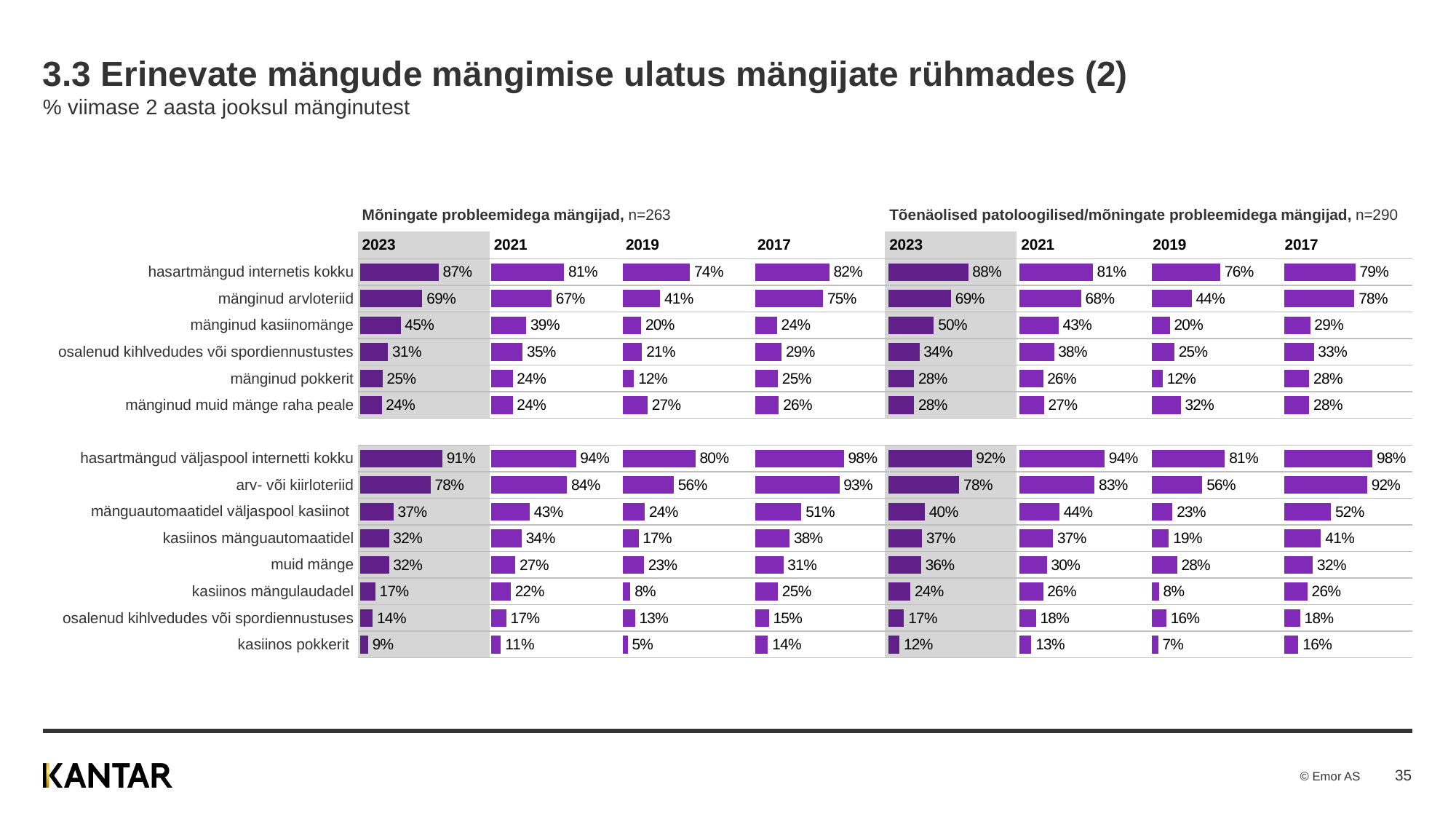
In the right chart (n=290), what is the difference between the 2023 and 2021 values for 'mänginud kasiinomänge'? 7 percentage points What type of chart is used on the slide? Bar chart In the right chart (n=290), which category has the highest 2023 value? hasartmängud väljaspool internetti kokku In the left chart (n=263), what is the difference between the 2017 and 2019 values for 'arv- või kiirloteriid'? 37 percentage points In the left chart (Mõningate probleemidega mängijad, n=263), what is the 2023 value for 'hasartmängud internetis kokku'? 87% In the left chart (n=263), which category has the lowest 2023 value? kasiinos pokkerit In the right chart (n=290), which is larger for 'kasiinos mänguautomaatidel': the 2017 value or the 2019 value? 2017 (41%) In the right chart (Tõenäolised patoloogilised/mõningate probleemidega mängijad, n=290), what is the 2017 value for 'mänginud arvloteriid'? 78% How many categories are listed in the lower block (starting with 'hasartmängud väljaspool internetti kokku')? 8 How many year columns are shown for each player group on the slide? 4 In the left chart (n=263), what is the 2019 value for 'kasiinos pokkerit'? 5% In the left chart (n=263), which is larger for 'mänginud kasiinomänge': the 2023 value or the 2021 value? 2023 (45%)